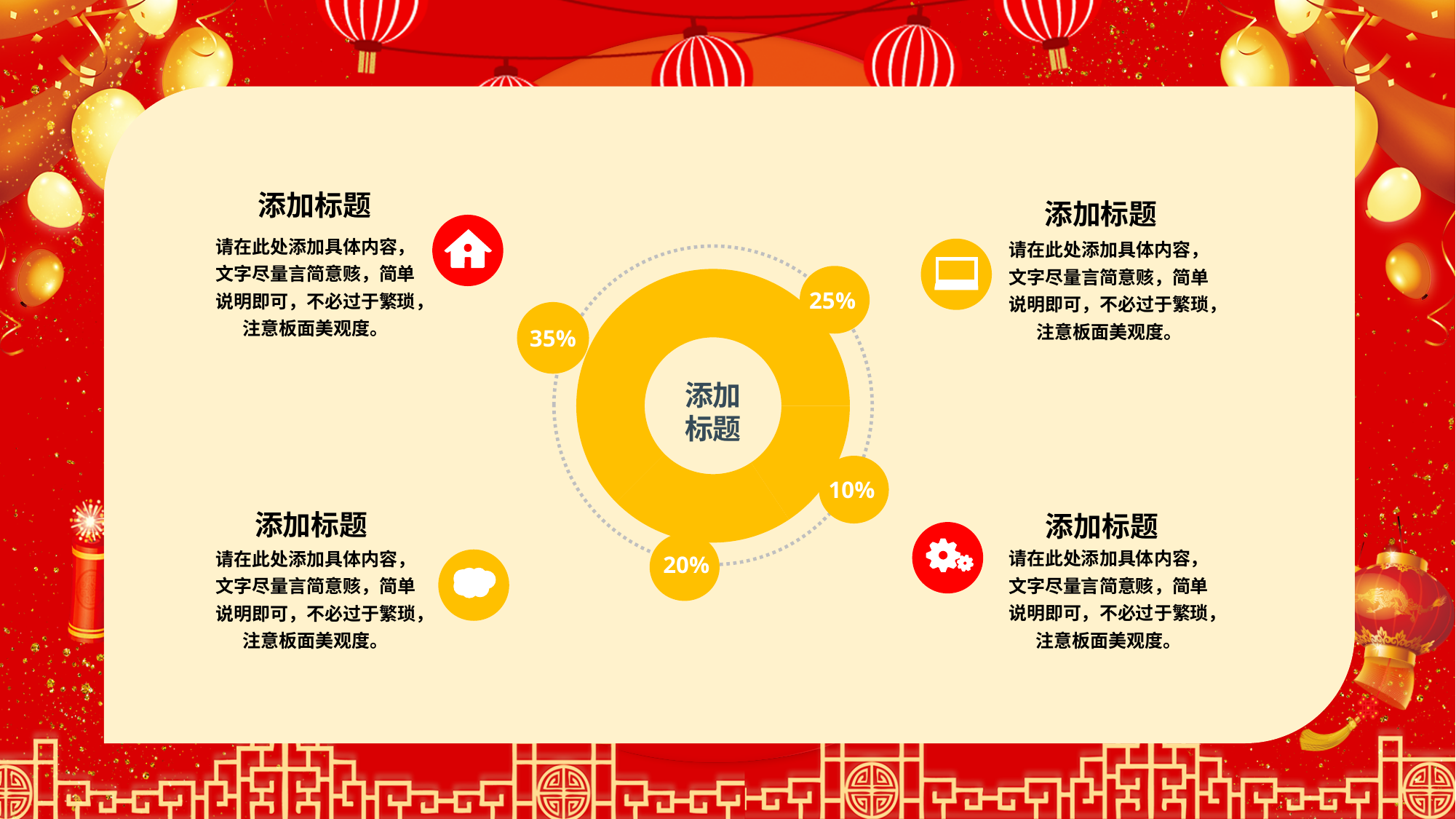
What percentage is shown in the circle at the top right of the ring chart? 25% What percentage is shown in the circle on the left side of the ring chart? 35% Which labelled value on the ring chart is the lowest? 10% What is the difference between the largest labelled value (35%) and the smallest labelled value (10%) on the ring chart? 25% Which is larger on the ring chart: the value at the top right (25%) or the value at the bottom (20%)? 25% What percentage is shown in the circle at the lower right of the ring chart? 10% What text appears in the centre of the ring chart? 添加标题 How many percentage values are labelled around the ring chart? 4 What percentage is shown in the circle at the bottom of the ring chart? 20% What kind of chart is shown in the centre of the slide? Donut chart Which labelled value on the ring chart is the highest? 35% What is the sum of the four percentage values labelled on the ring chart? 90%